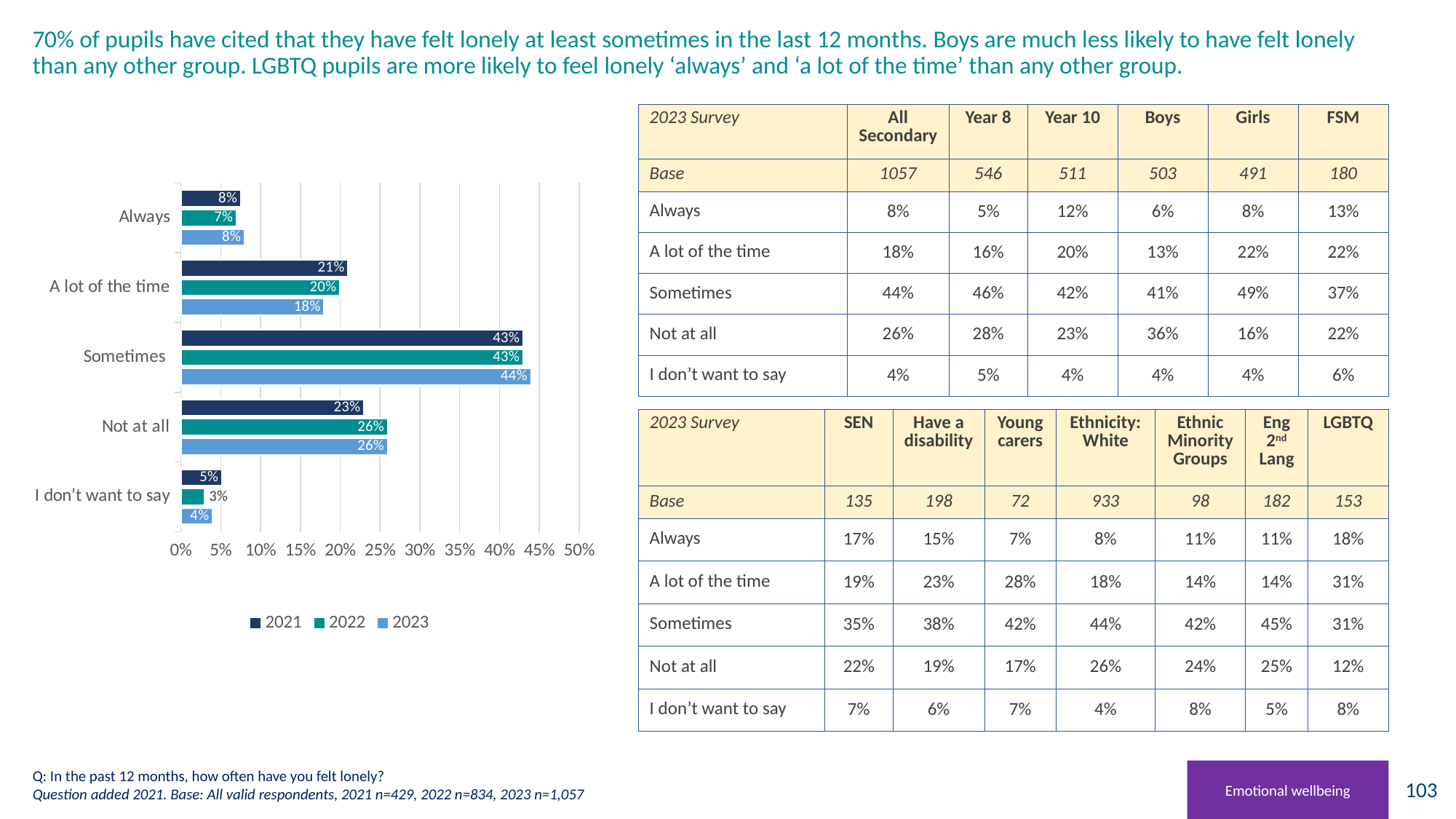
Is the 2022 value for 'Sometimes' in the chart greater or less than 40%? greater Which category has the lowest 2021 value in the chart? I don't want to say How many categories are shown on the chart? 5 What is the 2021 value for 'A lot of the time' in the chart? 21% Which series in the chart legend is shown in the darkest colour? 2021 What is the difference between the 2021 and 2023 values for 'A lot of the time' in the chart? 3% What is the 2023 value for 'Sometimes' in the chart? 44% How many series does the chart legend list? 3 What type of chart is shown on the slide? bar chart What is the 2022 value for 'I don't want to say' in the chart? 3% Which category has the highest 2023 value in the chart? Sometimes In the chart, is the 2021 value for 'Not at all' larger or smaller than the 2022 value for 'Not at all'? smaller